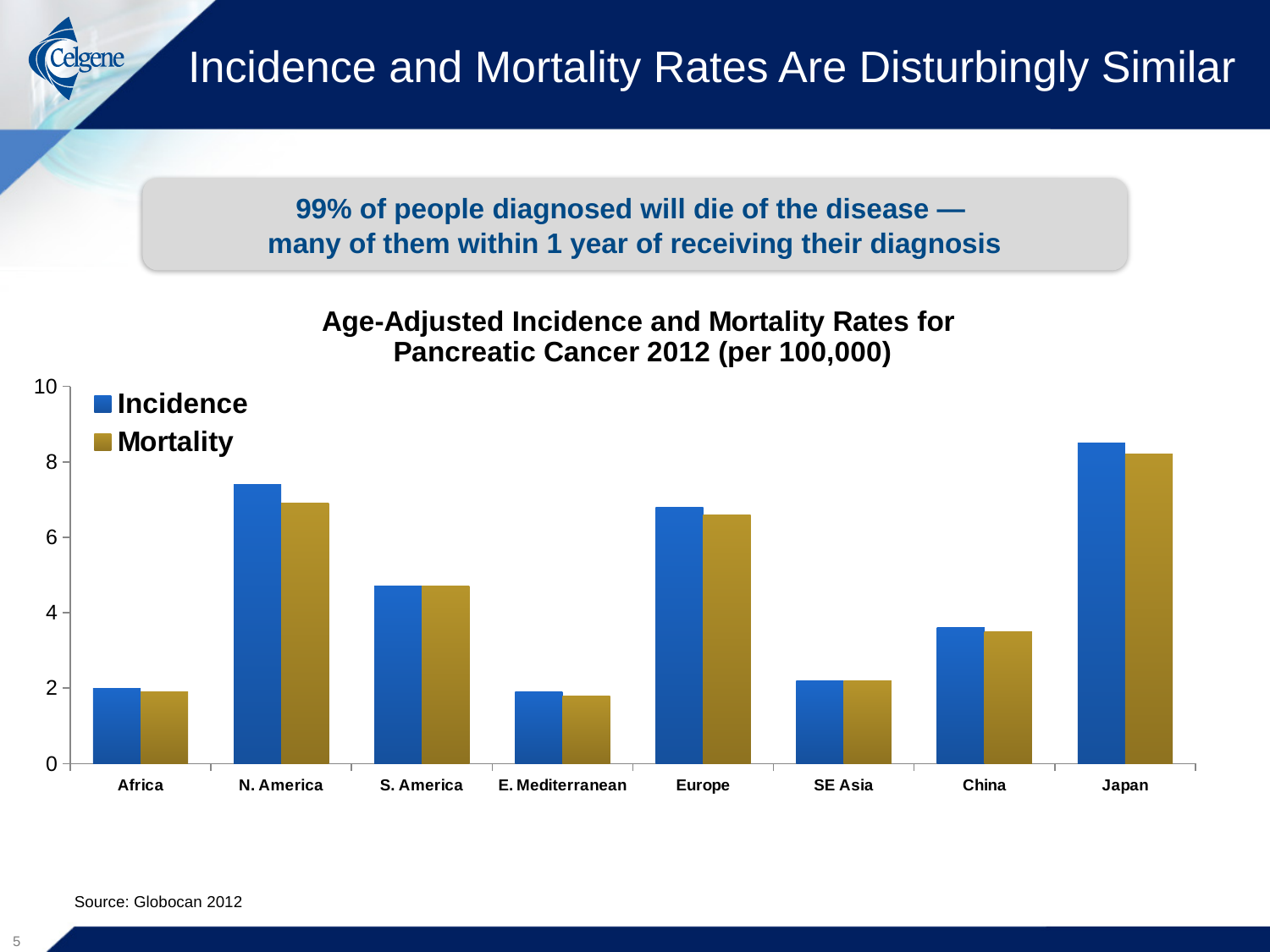
Is the incidence value for Japan greater or less than 8? greater Which region has the highest mortality rate in the chart? Japan Is the mortality value for China greater or less than 4? less Which has the larger incidence rate, N. America or Europe? N. America What is the title of the chart? Age-Adjusted Incidence and Mortality Rates for Pancreatic Cancer 2012 (per 100,000) How many regions are shown on the x axis of the chart? 8 Which has the larger mortality rate, China or SE Asia? China What kind of chart is shown on the slide? bar chart Is the mortality value for Europe greater or less than 6? greater How many series does the chart legend list? 2 Which region has the highest incidence rate in the chart? Japan